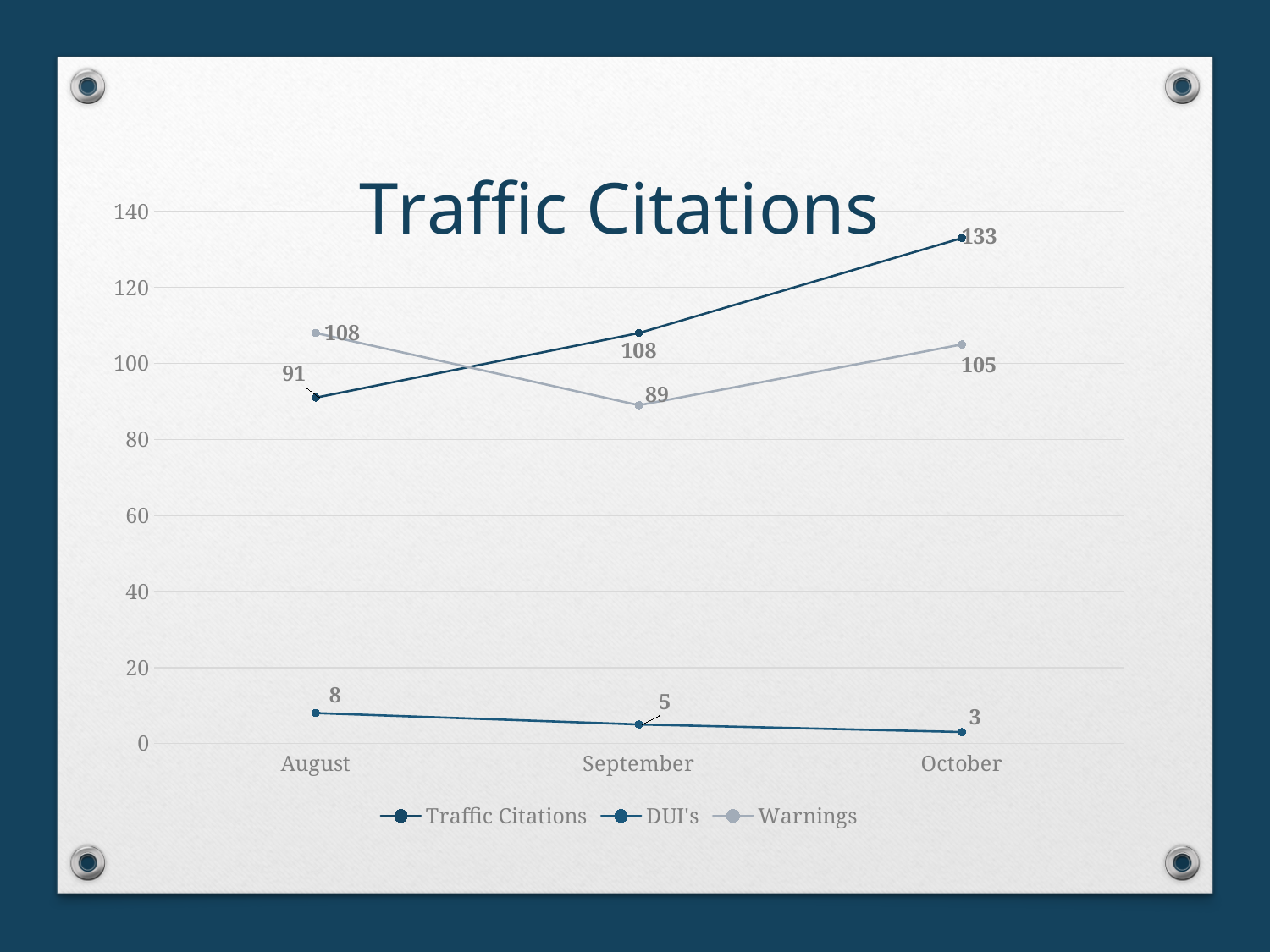
What is the difference between Traffic Citations in October and Traffic Citations in August? 42 In which month is the Warnings value lowest? September In which month is the Traffic Citations value highest? October How many series does the legend list? 3 How many months are shown on the x axis? 3 What kind of chart is shown on the slide? Line chart What is the value for Traffic Citations in October? 133 Which is larger in August: Traffic Citations or Warnings? Warnings What is the value for DUI's in August? 8 What is the value for Warnings in September? 89 What is the title of the chart? Traffic Citations Do the DUI's values rise or fall from August to October? Fall